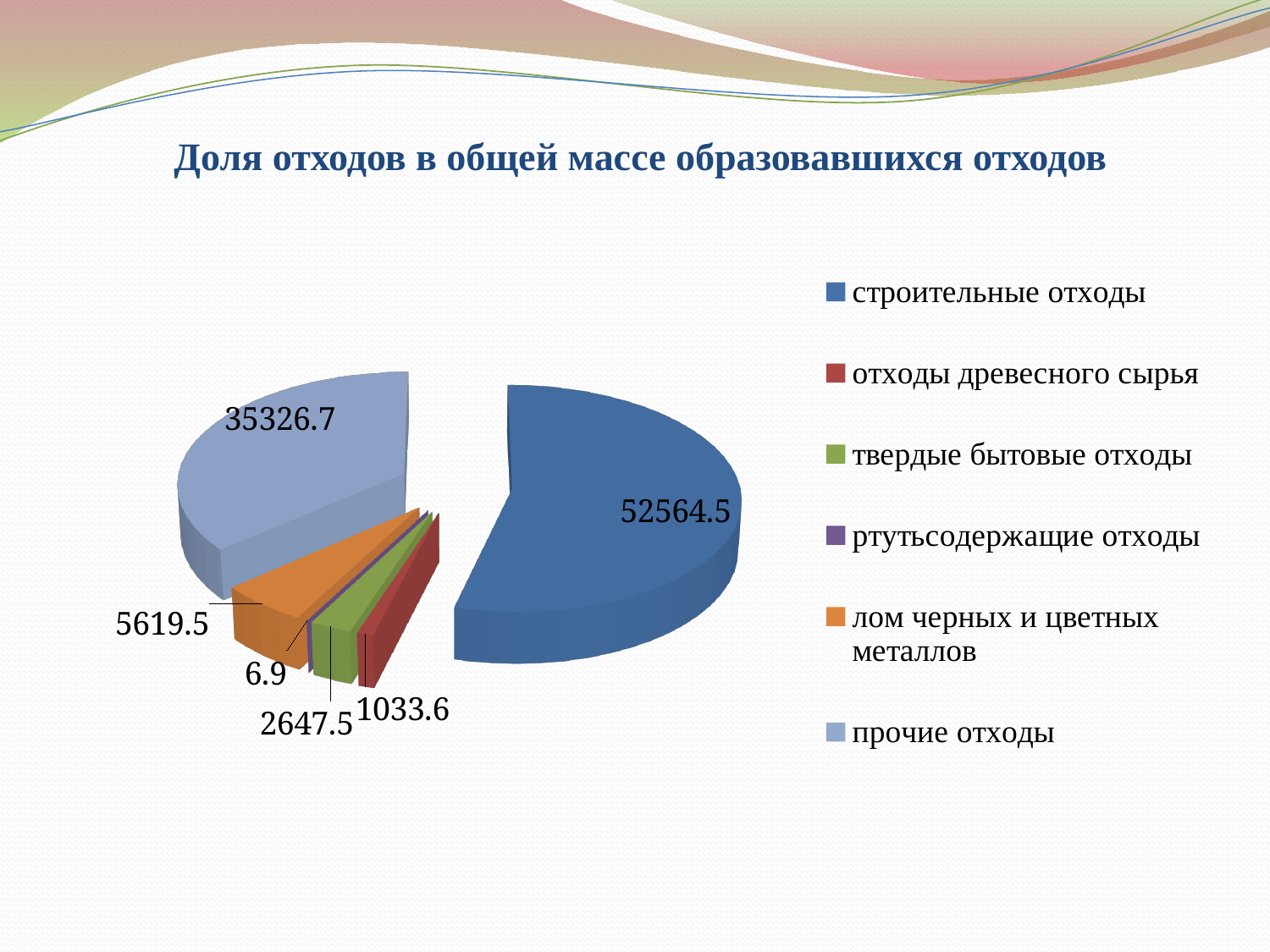
What is the value for ртутьсодержащие отходы? 6.9 What is the value for отходы древесного сырья? 1033.6 What is the value for строительные отходы? 52564.5 How many categories does the legend list? 6 What is the value for твердые бытовые отходы? 2647.5 What is the title of the chart? Доля отходов в общей массе образовавшихся отходов What is the difference between the values for строительные отходы and прочие отходы? 17237.8 What type of chart is shown on the slide? Pie chart What is the value for прочие отходы? 35326.7 Which category has the smallest slice? ртутьсодержащие отходы Which category has the largest slice? строительные отходы What is the value for лом черных и цветных металлов? 5619.5